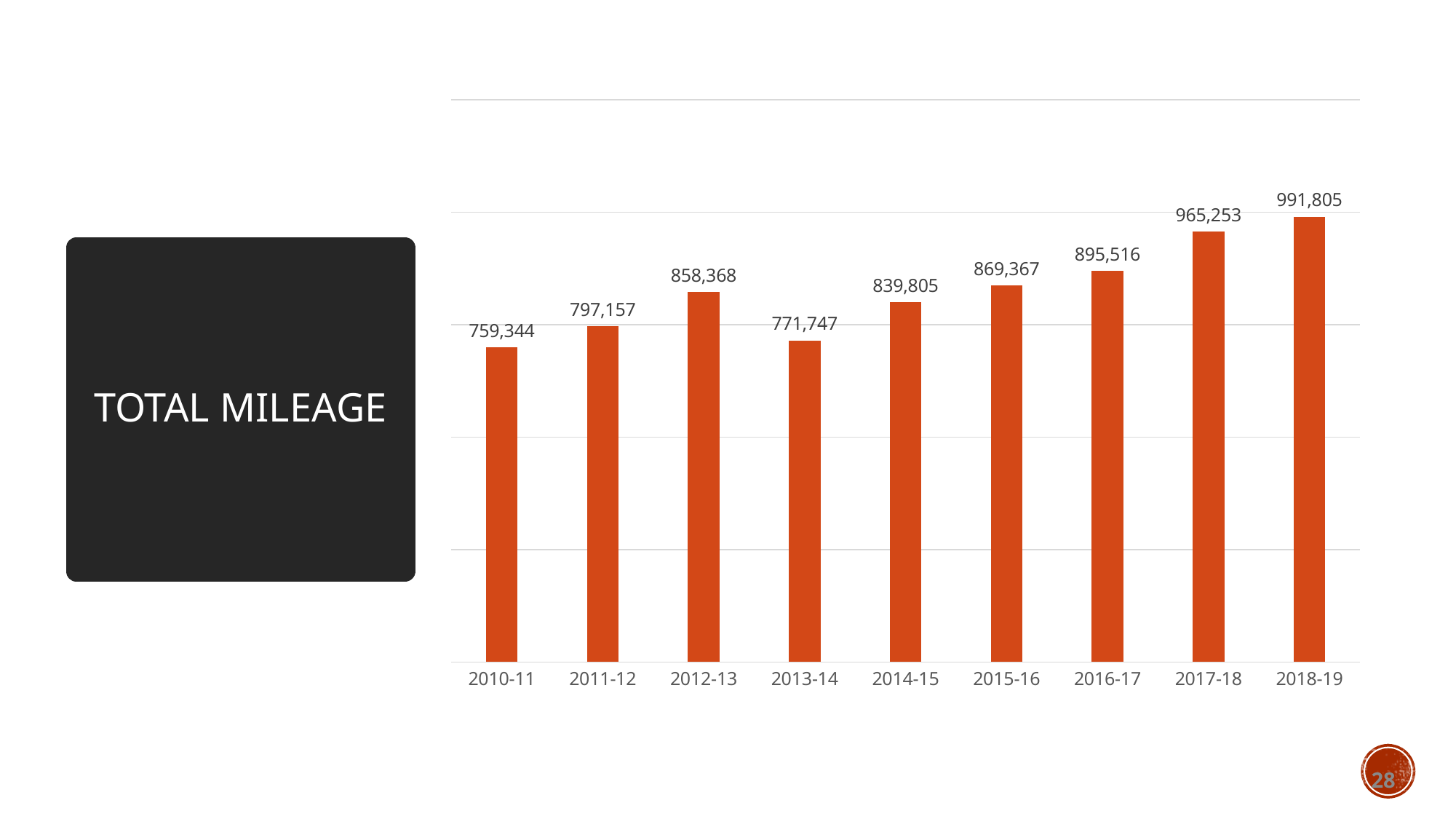
Which year has the larger total mileage, 2013-14 or 2011-12? 2011-12 What is the difference in total mileage between 2018-19 and 2010-11? 232,461 What is the total mileage for 2014-15? 839,805 Which year has the larger total mileage, 2012-13 or 2014-15? 2012-13 What is the total mileage for 2010-11? 759,344 What is the difference in total mileage between 2012-13 and 2013-14? 86,621 What kind of chart is shown on the slide? Bar chart Which year has the lowest total mileage? 2010-11 How many years are shown on the chart? 9 Does total mileage generally rise or fall from 2010-11 to 2018-19? Rise Which year has the highest total mileage? 2018-19 What is the total mileage for 2017-18? 965,253